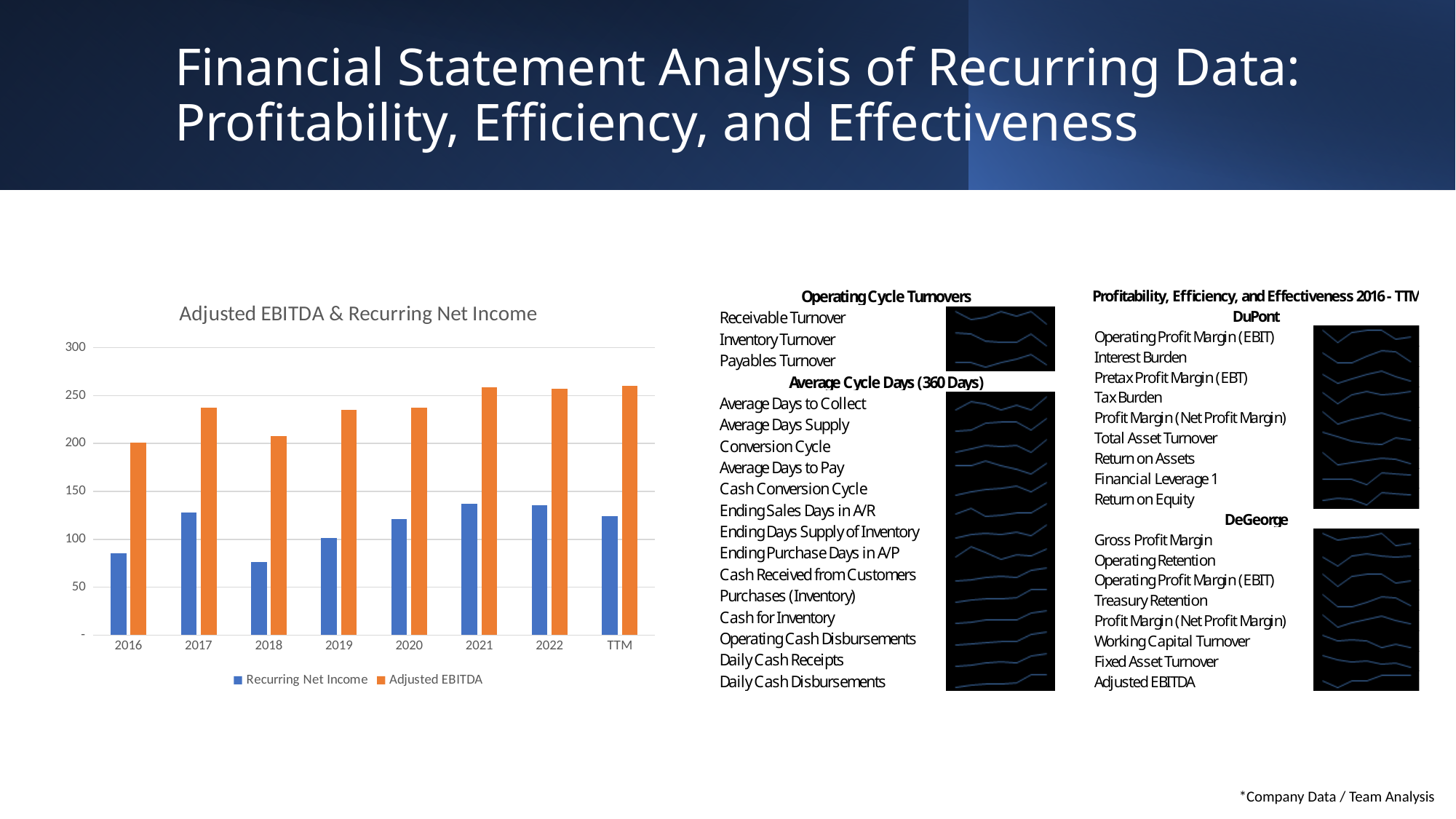
Does Recurring Net Income rise or fall from 2018 to 2021? Rise Is the Adjusted EBITDA for 2017 greater or less than 200? greater Which is larger, the Recurring Net Income for 2017 or for 2018? 2017 Is the Recurring Net Income for 2021 greater or less than 100? greater Is the Recurring Net Income for 2018 greater or less than 100? less Which colour represents Adjusted EBITDA in the chart? Orange What kind of chart is shown on the slide? Bar chart What is the title of the chart on the slide? Adjusted EBITDA & Recurring Net Income How many categories are shown along the x axis of the chart? 8 In 2020, which series has the larger value, Recurring Net Income or Adjusted EBITDA? Adjusted EBITDA How many series does the chart's legend list? 2 Which year has the lowest Recurring Net Income? 2018